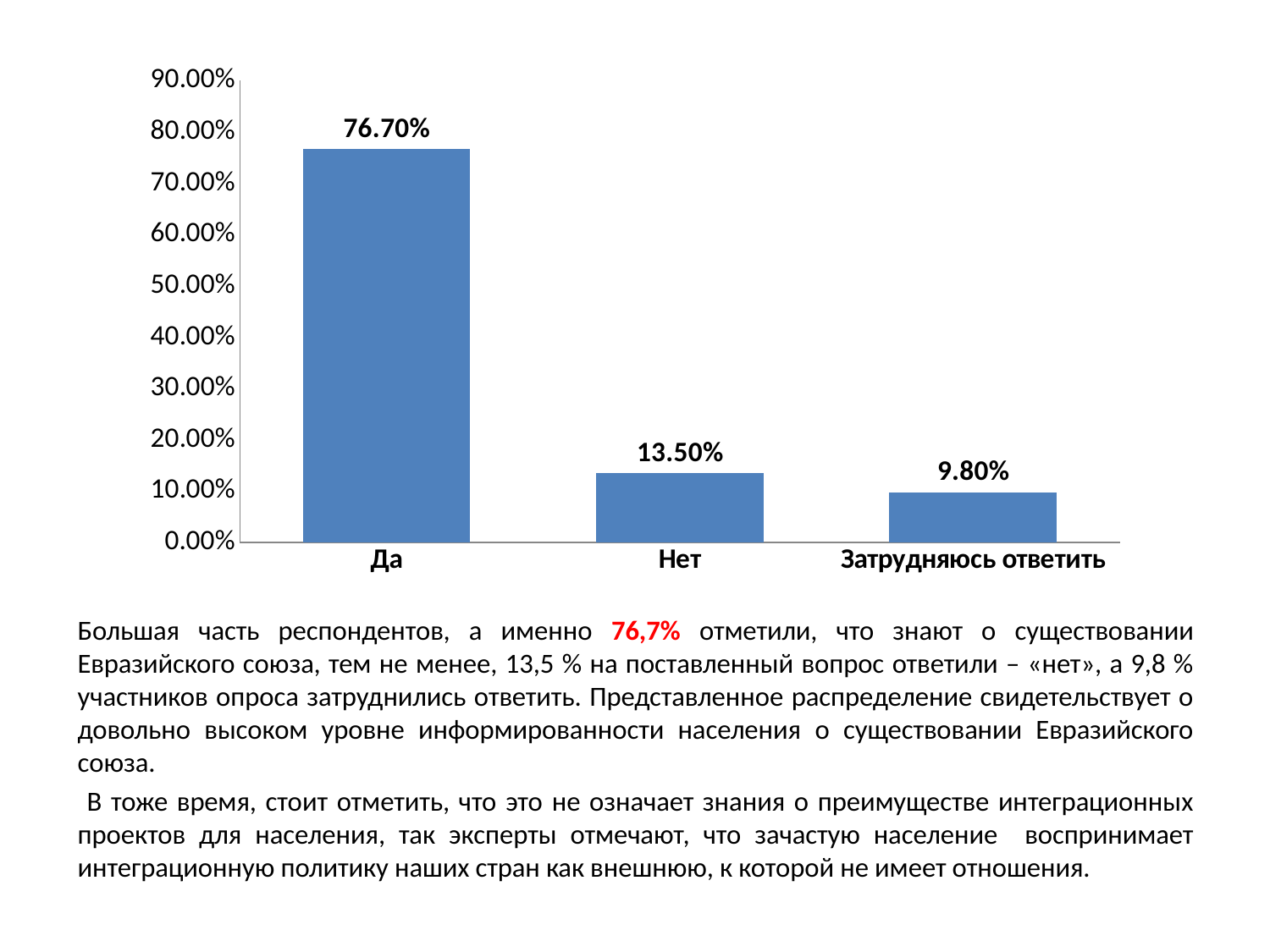
What is the value for Да? 76.70% Is the value for Да greater or less than 70.00%? greater What is the difference between the values for Нет and Затрудняюсь ответить? 3.70% What is the difference between the values for Да and Нет? 63.20% Which is larger, the value for Нет or the value for Затрудняюсь ответить? Нет Which category has the lowest value? Затрудняюсь ответить Do the values rise or fall from left to right along the x axis? fall What kind of chart is shown on the slide? bar chart What is the value for Нет? 13.50% What is the value for Затрудняюсь ответить? 9.80% How many categories are shown on the x axis? 3 Which category has the highest value? Да